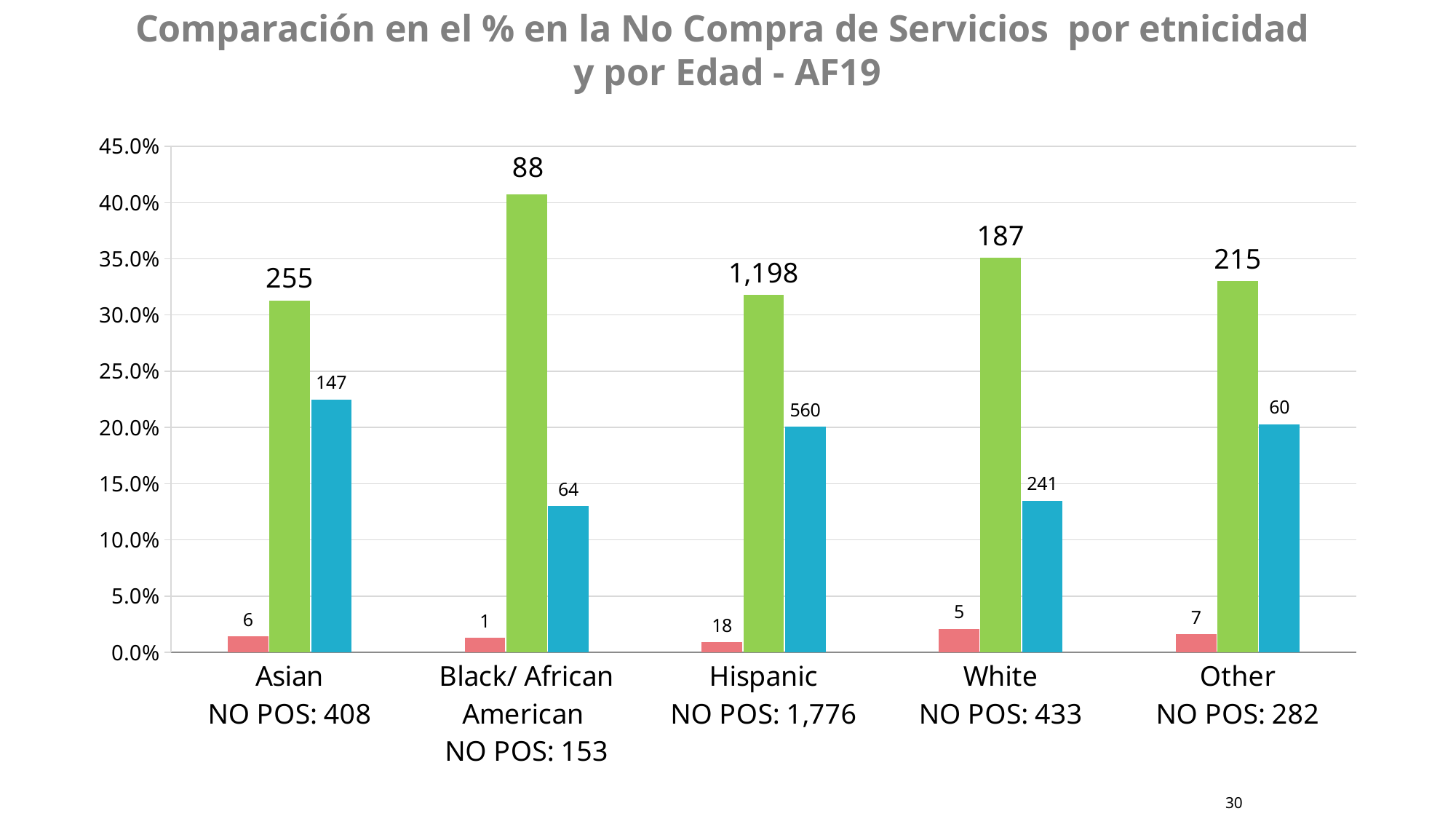
How many ethnicity categories are shown on the x axis? 5 Which is taller, the green bar for Asian or the green bar for White? White What is the data label on the green bar for Black/ African American? 88 Is the blue bar for Black/ African American greater or less than 15.0%? less What kind of chart is shown on the slide? bar chart Which category has the tallest blue bar? Asian Which category has the tallest green bar? Black/ African American What is the data label on the blue bar for Hispanic? 560 What is the data label on the pink bar for White? 5 Is the green bar for Black/ African American greater or less than 35.0%? greater What is the data label on the green bar for Asian? 255 What NO POS value is shown under the Hispanic category label? NO POS: 1,776